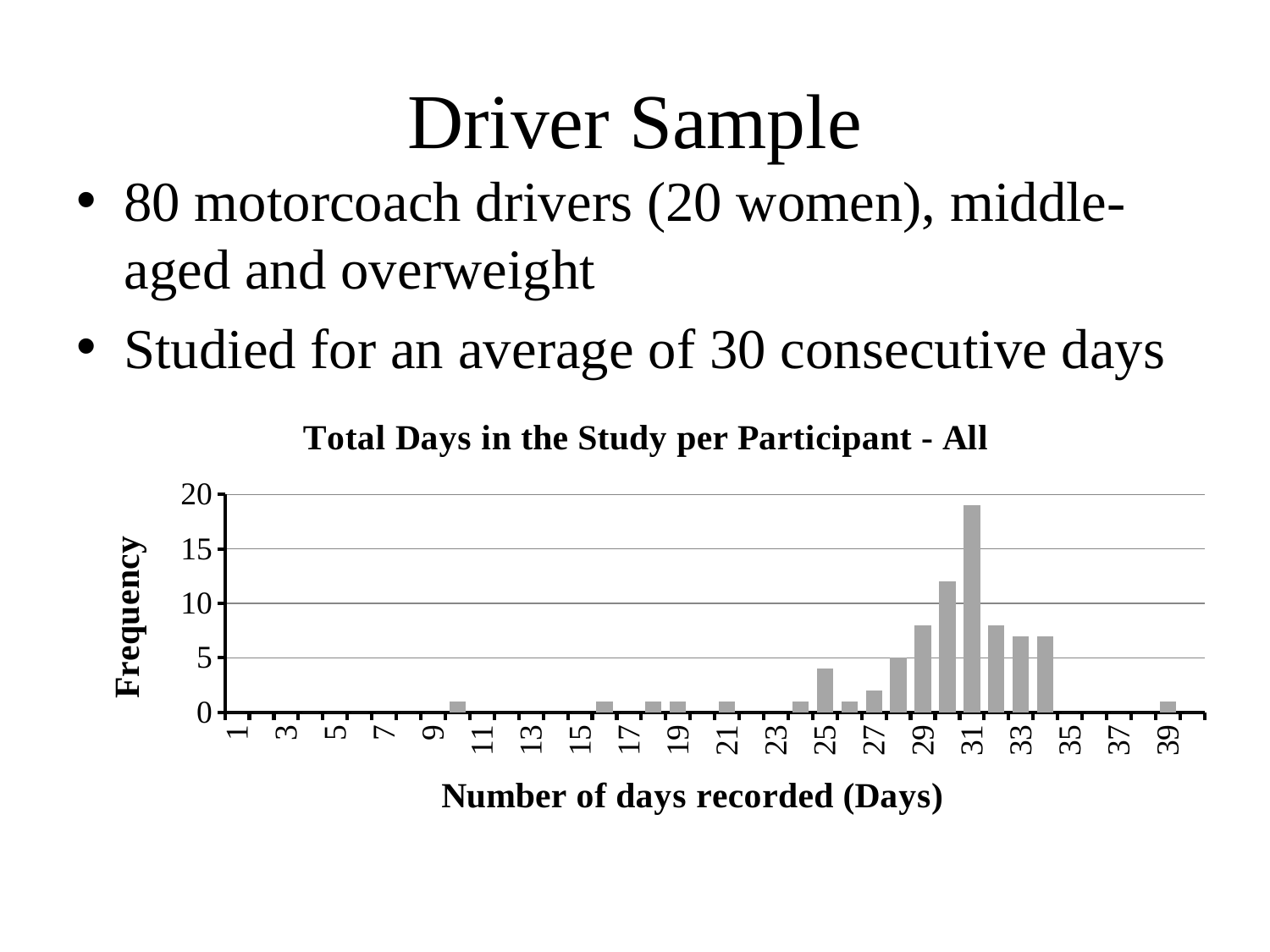
Which has the higher frequency, 25 days or 27 days? 25 days Is the frequency for 30 days greater or less than 10? greater What is the label of the x axis of the chart? Number of days recorded (Days) What is the title of the chart? Total Days in the Study per Participant - All Which has the higher frequency, 30 days or 31 days? 31 days Is the frequency for 31 days greater or less than 15? greater Is the frequency for 32 days greater or less than 10? less What kind of chart is shown on the slide? bar chart Which number of days recorded has the highest frequency? 31